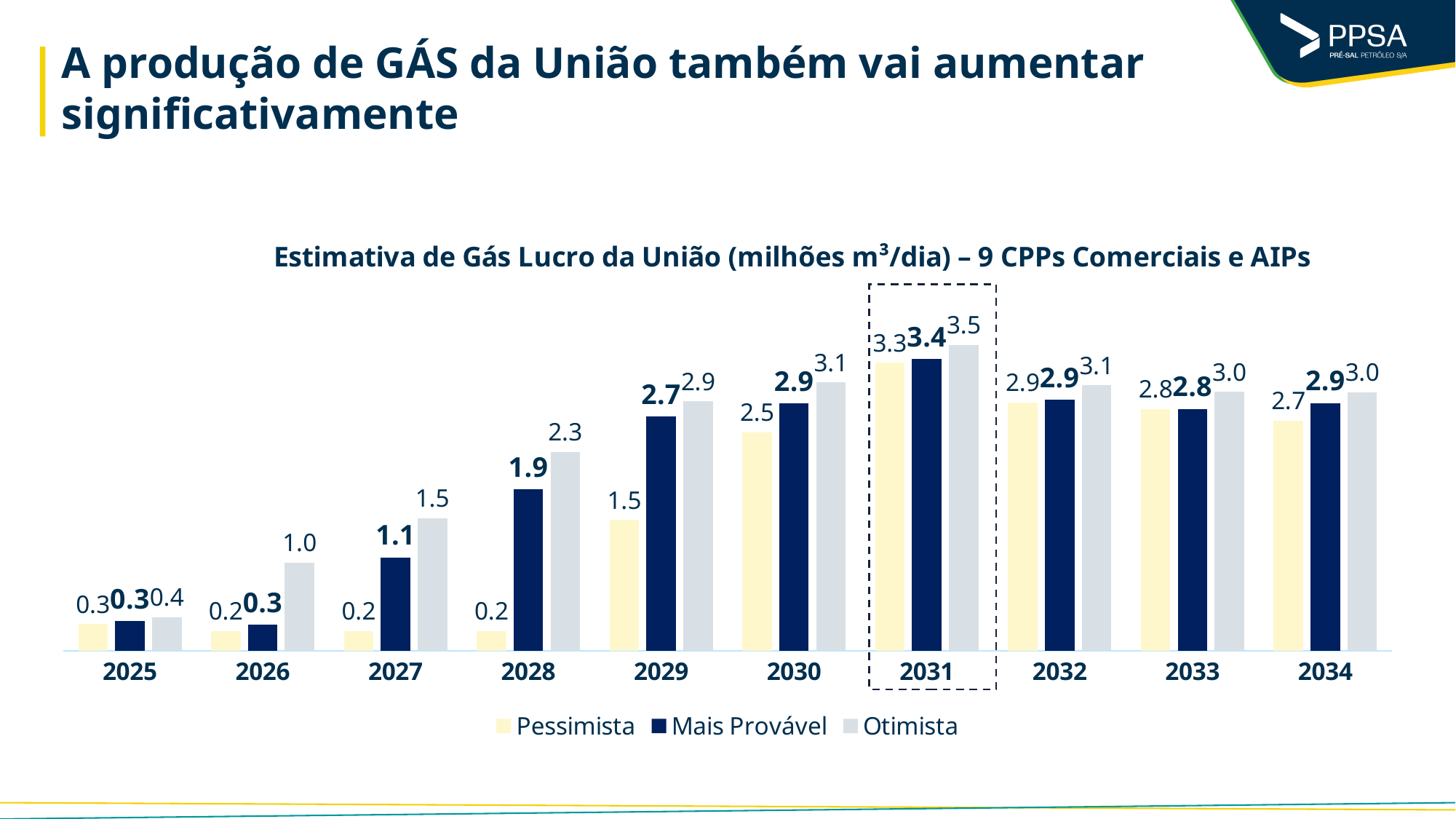
Does the Mais Provável series rise or fall from 2025 to 2031? Rise What is the Pessimista value for 2029? 1.5 How many years are shown on the x axis? 10 How many series does the legend list? 3 In which year is the Otimista value highest? 2031 What is the Mais Provável value for 2027? 1.1 What is the Otimista value for 2028? 2.3 What is the difference between the Otimista and Pessimista values for 2028? 2.1 Which is larger, the Pessimista value for 2030 or the Pessimista value for 2031? 2031 In which year is the Mais Provável value lowest? 2025 and 2026 (both 0.3) What kind of chart is shown on the slide? Bar chart What is the Mais Provável value for 2031? 3.4